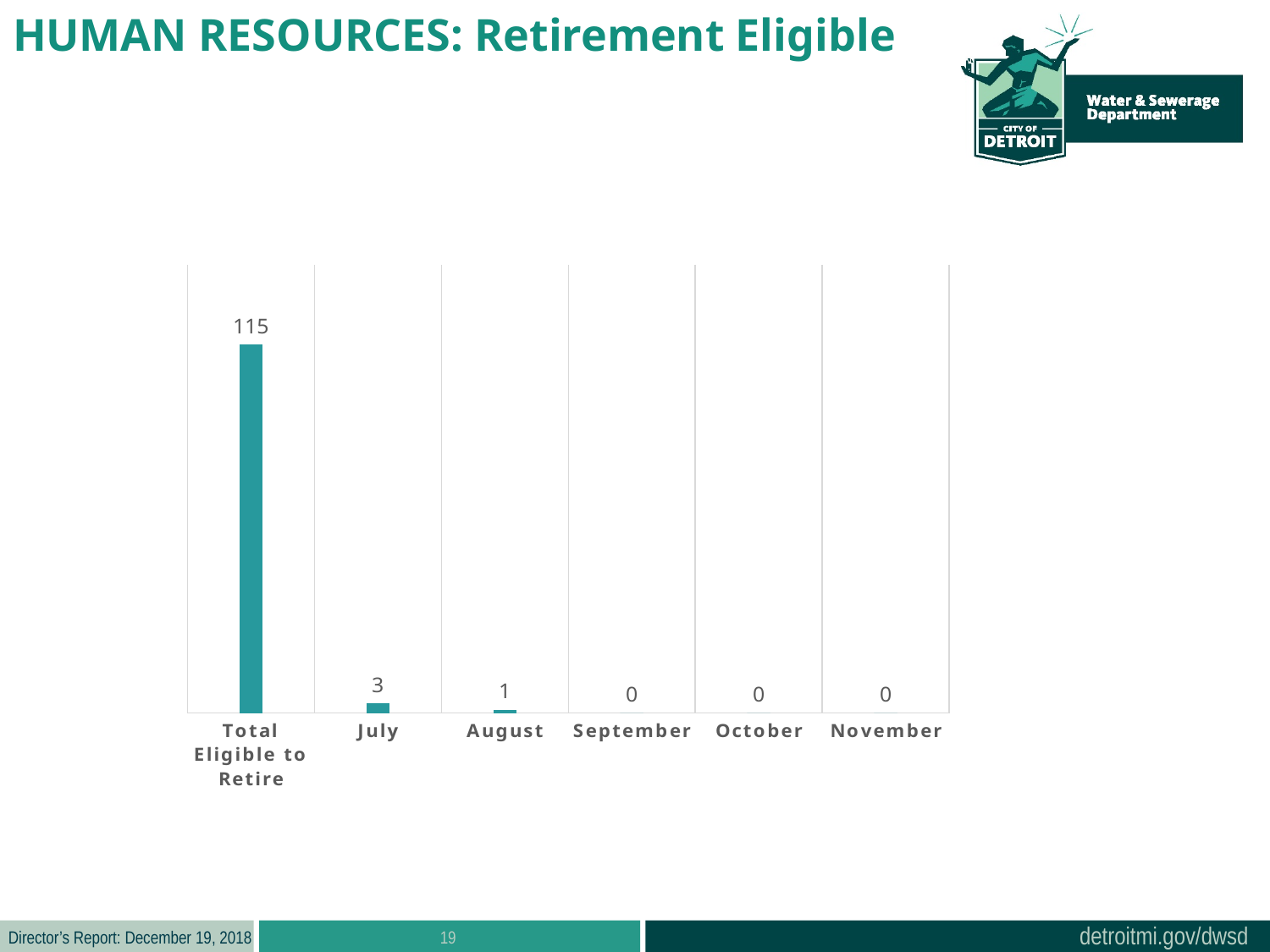
What is the title of the slide containing the chart? HUMAN RESOURCES: Retirement Eligible Which is larger, the value for July or the value for August? July What kind of chart is shown on the slide? Bar chart What is the value for August? 1 How many categories have a value of 0? 3 How many categories are shown on the x axis? 6 What is the value for Total Eligible to Retire? 115 Which category has the highest value? Total Eligible to Retire What is the value for October? 0 What is the difference between the values for July and August? 2 What is the difference between the values for Total Eligible to Retire and July? 112 What is the value for July? 3